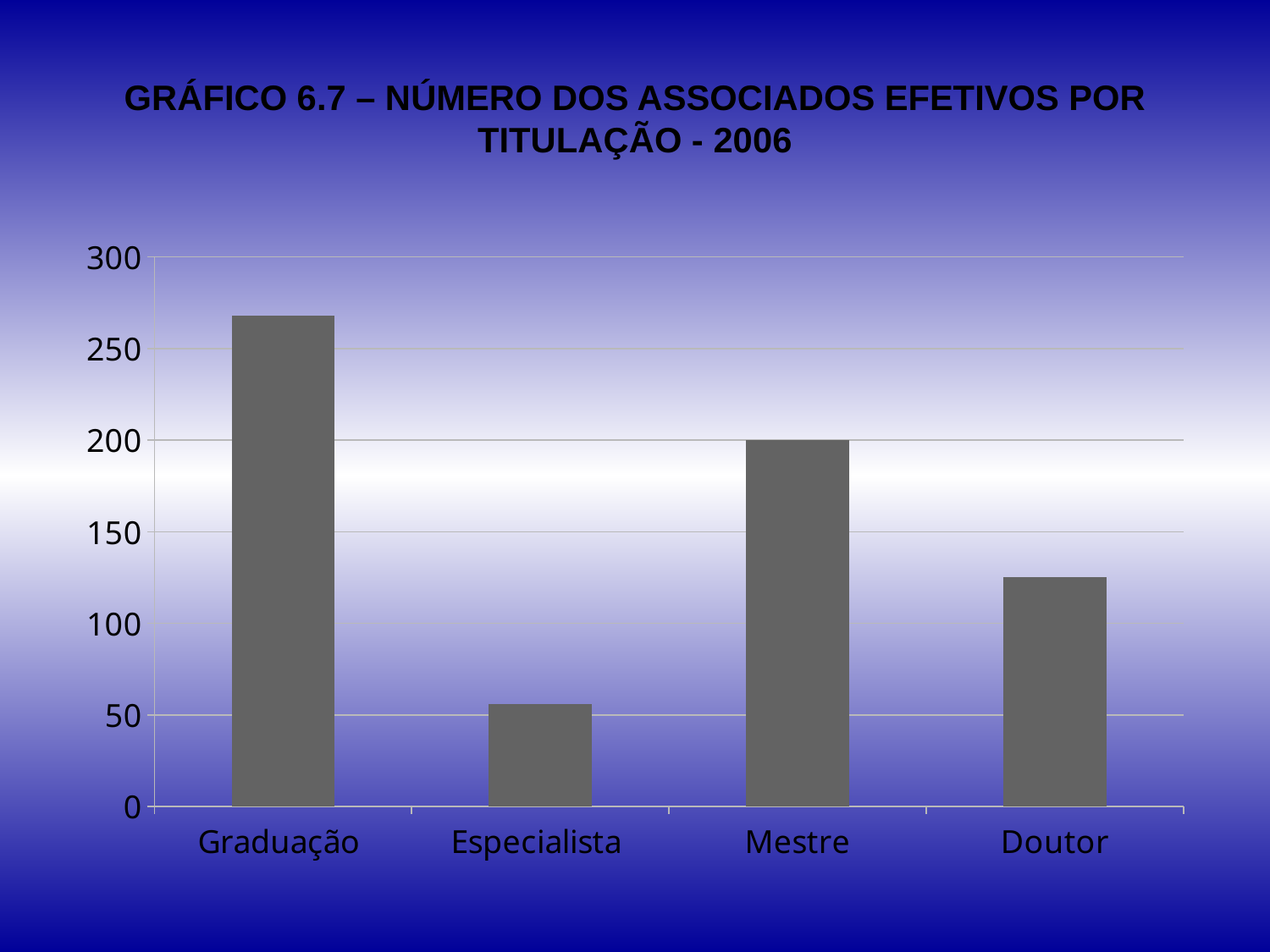
What kind of chart is shown on the slide? bar chart Which category has the lowest number of associados efetivos? Especialista Is the value for Especialista greater or less than 100? less Which is larger, the value for Mestre or the value for Doutor? Mestre How many categories are shown on the x axis of the chart? 4 What is the highest value shown on the y axis of the chart? 300 What is the title of the chart? GRÁFICO 6.7 – NÚMERO DOS ASSOCIADOS EFETIVOS POR TITULAÇÃO - 2006 Is the value for Doutor greater or less than 100? greater Which is larger, the value for Graduação or the value for Mestre? Graduação Is the value for Graduação greater or less than 250? greater Which category has the highest number of associados efetivos? Graduação